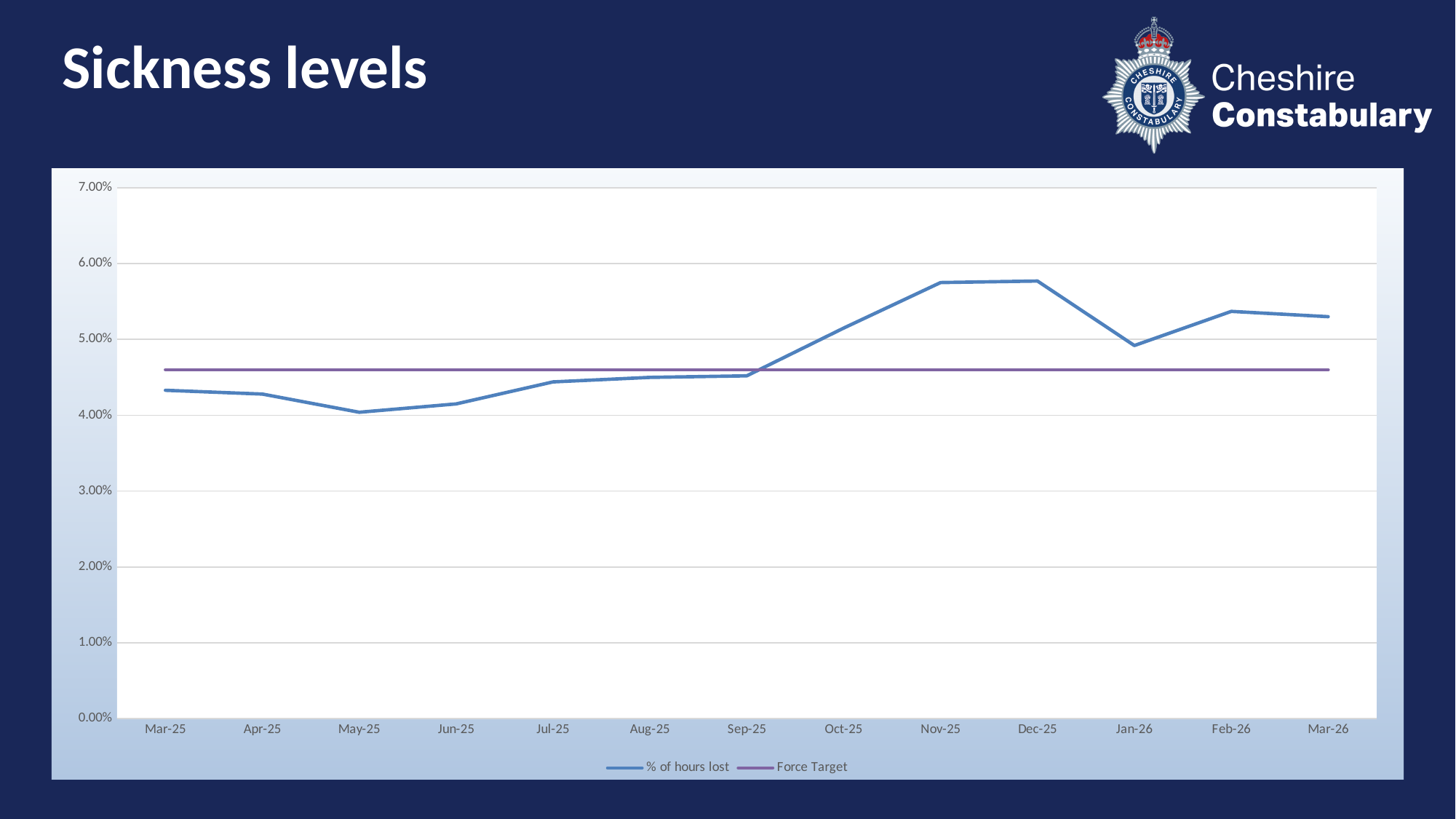
Which is higher for % of hours lost: May-25 or Jul-25? Jul-25 How many series does the legend list? 2 How many months are plotted along the x axis? 13 What kind of chart is shown on the slide? line chart Is the Force Target line greater or less than 4.00%? greater Is the value for % of hours lost in Nov-25 greater or less than 5.00%? greater Is the value for % of hours lost in Dec-25 greater or less than 6.00%? less Does the % of hours lost line rise or fall between Sep-25 and Nov-25? rise What are the two series named in the legend? % of hours lost and Force Target Which is higher for % of hours lost: Nov-25 or Jan-26? Nov-25 Which month has the lowest value for % of hours lost? May-25